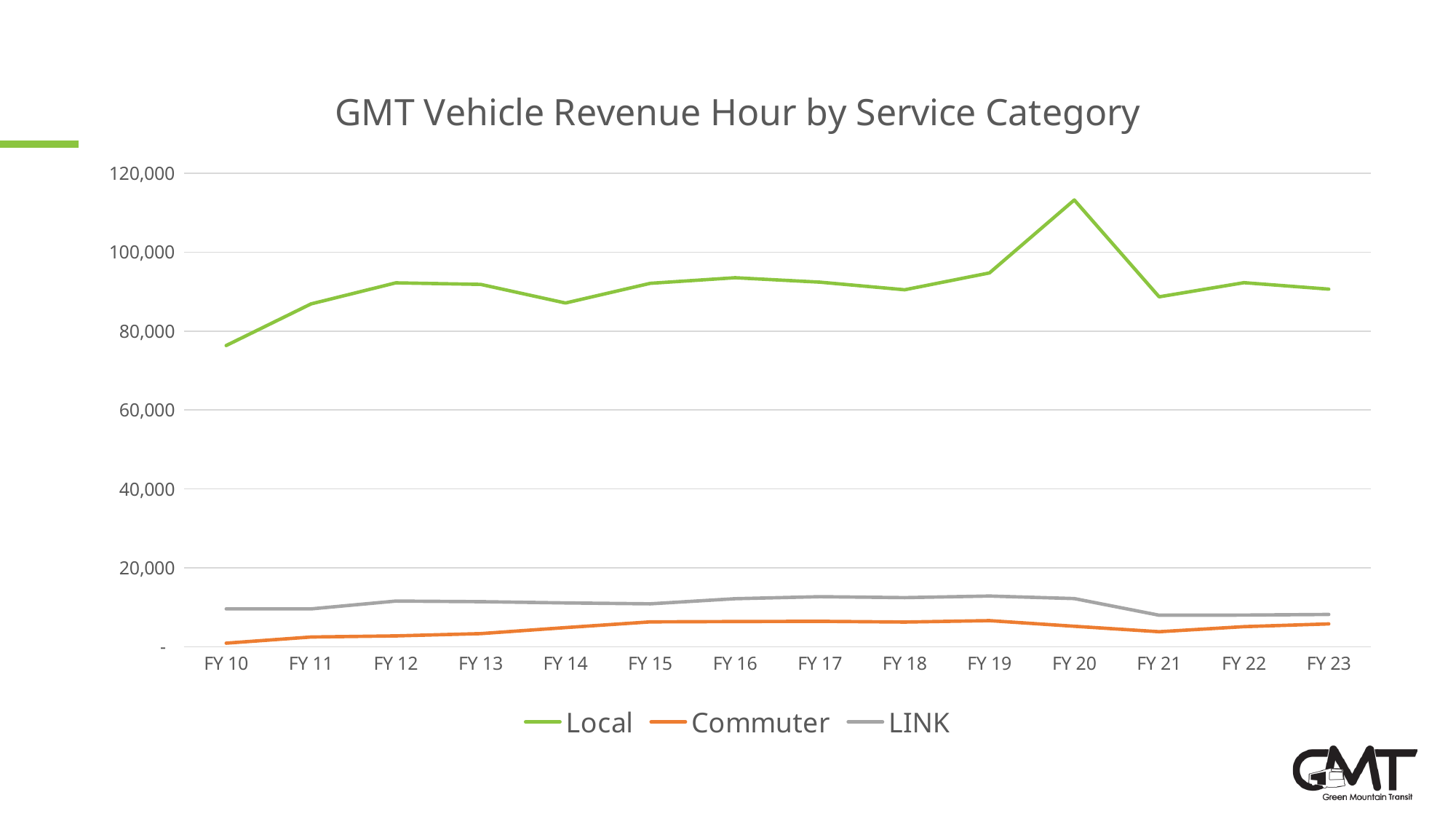
What kind of chart is shown on the slide? line chart Which series are listed in the legend? Local, Commuter, LINK What is the title of the chart? GMT Vehicle Revenue Hour by Service Category How many series does the legend list? 3 In which fiscal year does the Local series reach its highest value? FY 20 Is the value for LINK in FY 19 greater or less than 20,000? less Is the value for Local in FY 20 greater or less than 100,000? greater Which series has the larger value in FY 15, Commuter or LINK? LINK Does the Local series rise or fall from FY 20 to FY 21? fall In which fiscal year is the Local series at its lowest value? FY 10 How many fiscal years are shown on the x axis? 14 Is the value for Local in FY 10 greater or less than 80,000? less